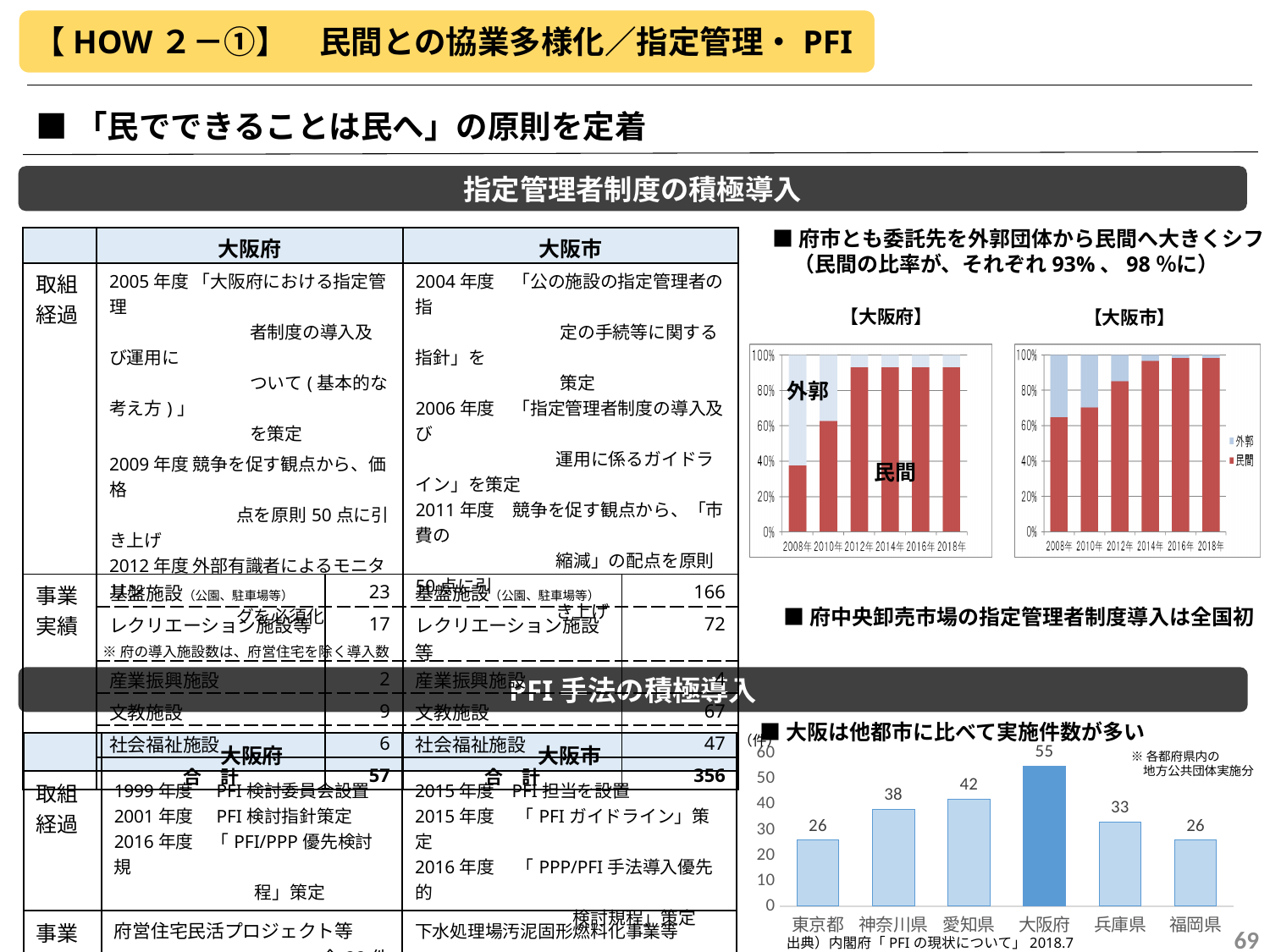
How many prefectures are shown in the bottom-right bar chart of PFI implementation counts? 6 In the 【大阪市】 stacked chart, is the 民間 value for 2014年 greater or less than 80%? greater What type of chart is the bottom-right chart of PFI implementation counts? bar chart In the bottom-right bar chart of PFI implementation counts, which is larger, 愛知県 or 兵庫県? 愛知県 In the bottom-right bar chart of PFI implementation counts, which prefecture has the highest value? 大阪府 How many series does the legend list in the 【大阪市】 stacked chart? 2 In the bottom-right bar chart of PFI implementation counts, what is the value for 兵庫県? 33 In the bottom-right bar chart of PFI implementation counts, what is the difference between 大阪府 and 東京都? 29 In the 【大阪府】 stacked chart, is the 民間 value for 2010年 greater or less than 60%? greater In the bottom-right bar chart of PFI implementation counts, what is the value for 大阪府? 55 In the bottom-right bar chart of PFI implementation counts, what is the difference between 愛知県 and 神奈川県? 4 In the bottom-right bar chart of PFI implementation counts, what is the value for 神奈川県? 38